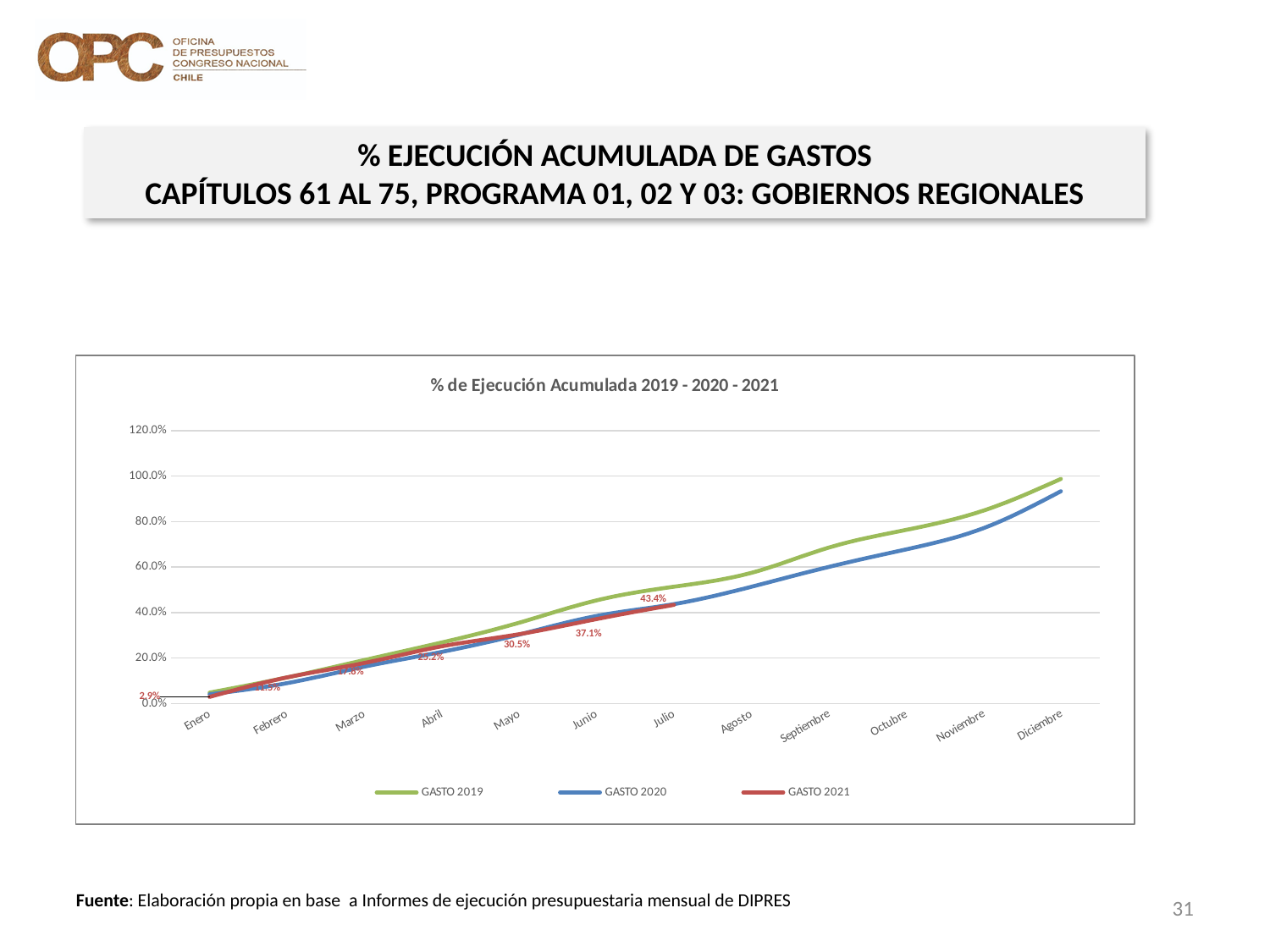
What is the value of GASTO 2021 in Mayo? 30.5% How many months are shown on the x axis of the chart? 12 Is the value for GASTO 2020 in Diciembre greater or less than 80%? greater What kind of chart is shown on the slide? line chart What is the value of GASTO 2021 in Junio? 37.1% What is the difference between the GASTO 2021 values for Julio and Junio? 6.3% How many series does the chart legend list? 3 What is the value of GASTO 2021 in Enero? 2.9% Which series has the higher value in Diciembre, GASTO 2019 or GASTO 2020? GASTO 2019 Do the GASTO 2019 values rise or fall from Enero to Diciembre? rise What is the difference between the GASTO 2021 values for Mayo and Abril? 5.3% What is the value of GASTO 2021 in Julio? 43.4%